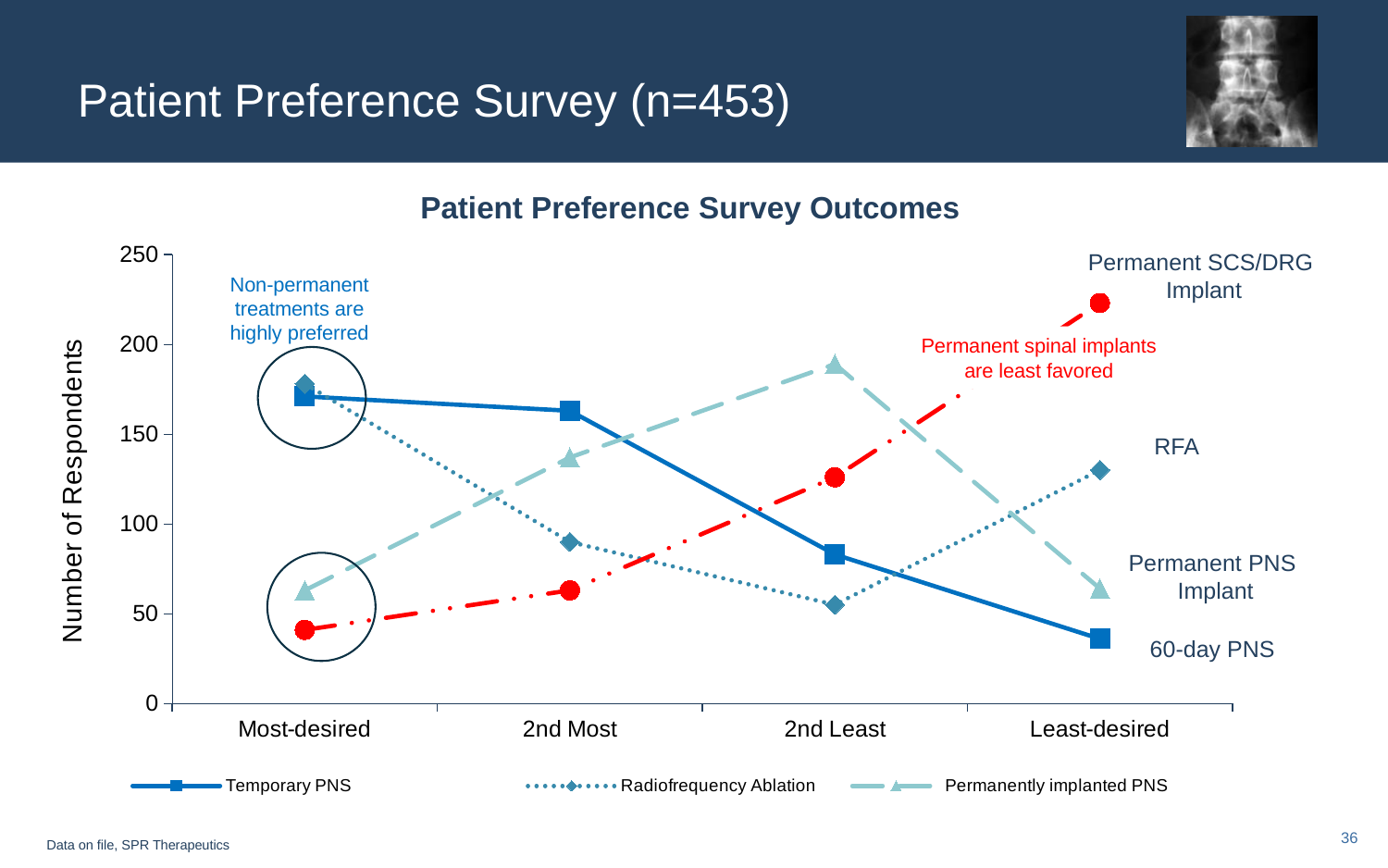
Is the value for Permanent SCS/DRG Implant at Least-desired greater or less than 200? greater How many series does the legend list? 3 Is the value for Temporary PNS at Least-desired greater or less than 50? less Is the value for Temporary PNS at Most-desired greater or less than 150? greater At Least-desired, which is larger: Permanent SCS/DRG Implant or Temporary PNS? Permanent SCS/DRG Implant In which category does Temporary PNS have its highest value? Most-desired What is the title of the chart? Patient Preference Survey Outcomes How many categories are shown on the x axis? 4 What kind of chart is shown on the slide? Line chart Do the values for Temporary PNS rise or fall from Most-desired to Least-desired? fall